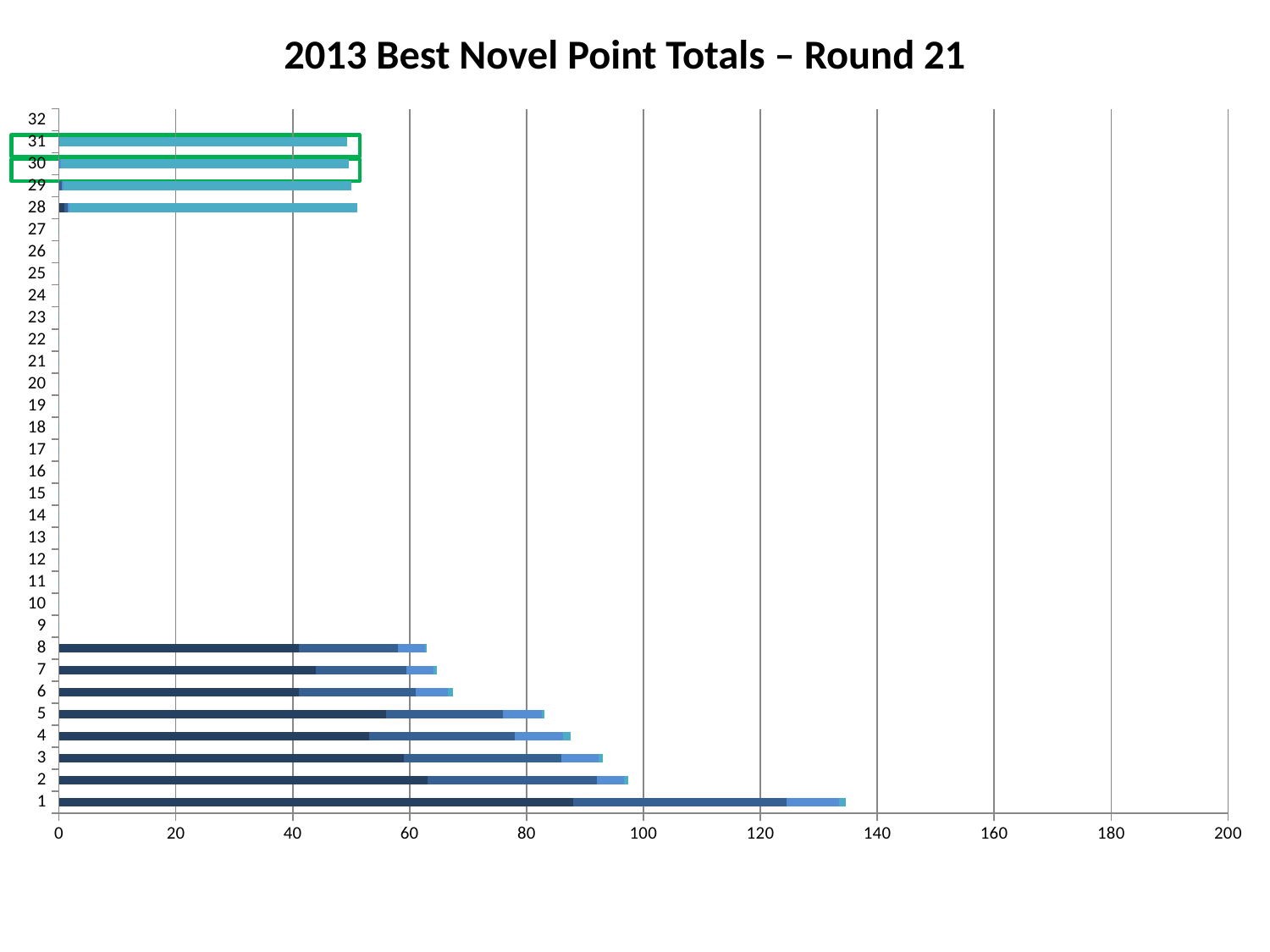
Is the total value for category 1 greater or less than 120? greater What kind of chart is shown on the slide? bar chart What is the title of the chart? 2013 Best Novel Point Totals – Round 21 Is the total value for category 28 greater or less than 40? greater Which category has the longest bar? 1 Which has the larger total, category 1 or category 2? 1 Which has the larger total, category 8 or category 28? 8 Is the total value for category 6 greater or less than 80? less Going from category 1 up to category 8, do the bar totals rise or fall? fall Which two categories are outlined with green rectangles? 30 and 31